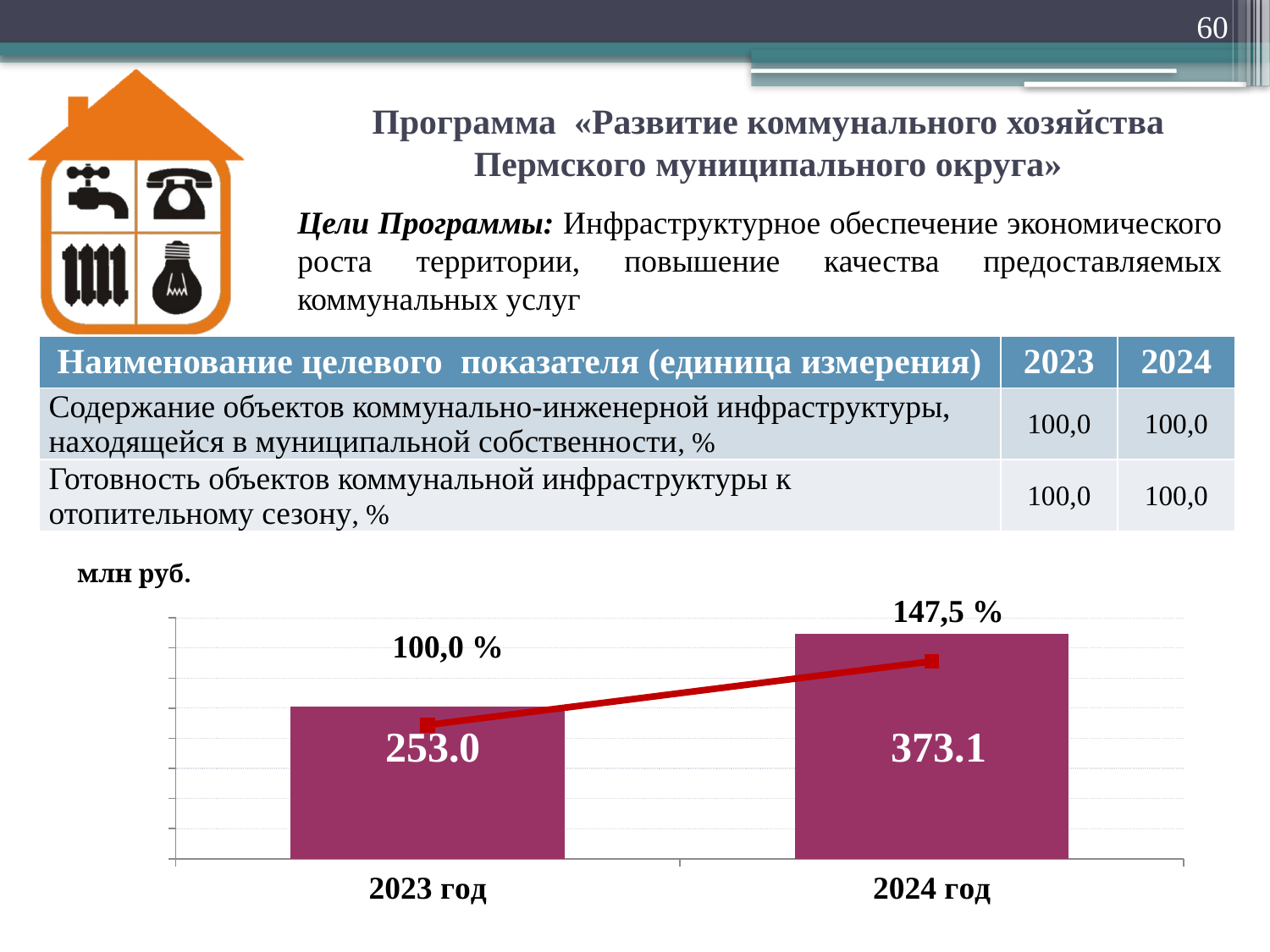
What is the value for 2024 год in the bar chart? 373.1 What is the value for 2023 год in the bar chart? 253.0 What kind of chart is shown at the bottom of the slide? combination bar and line chart What is the difference between the values for 2024 год and 2023 год in the bar chart? 120.1 Which year has the lower bar in the chart? 2023 год How many bars are shown in the chart? 2 What unit is indicated above the chart? млн руб. Which year has the higher bar in the chart? 2024 год What percentage label is shown above the 2023 год bar? 100,0 % Is the value for 2024 год larger or smaller than the value for 2023 год? larger What percentage label is shown above the 2024 год bar? 147,5 % Do the bar values rise or fall from 2023 год to 2024 год? rise